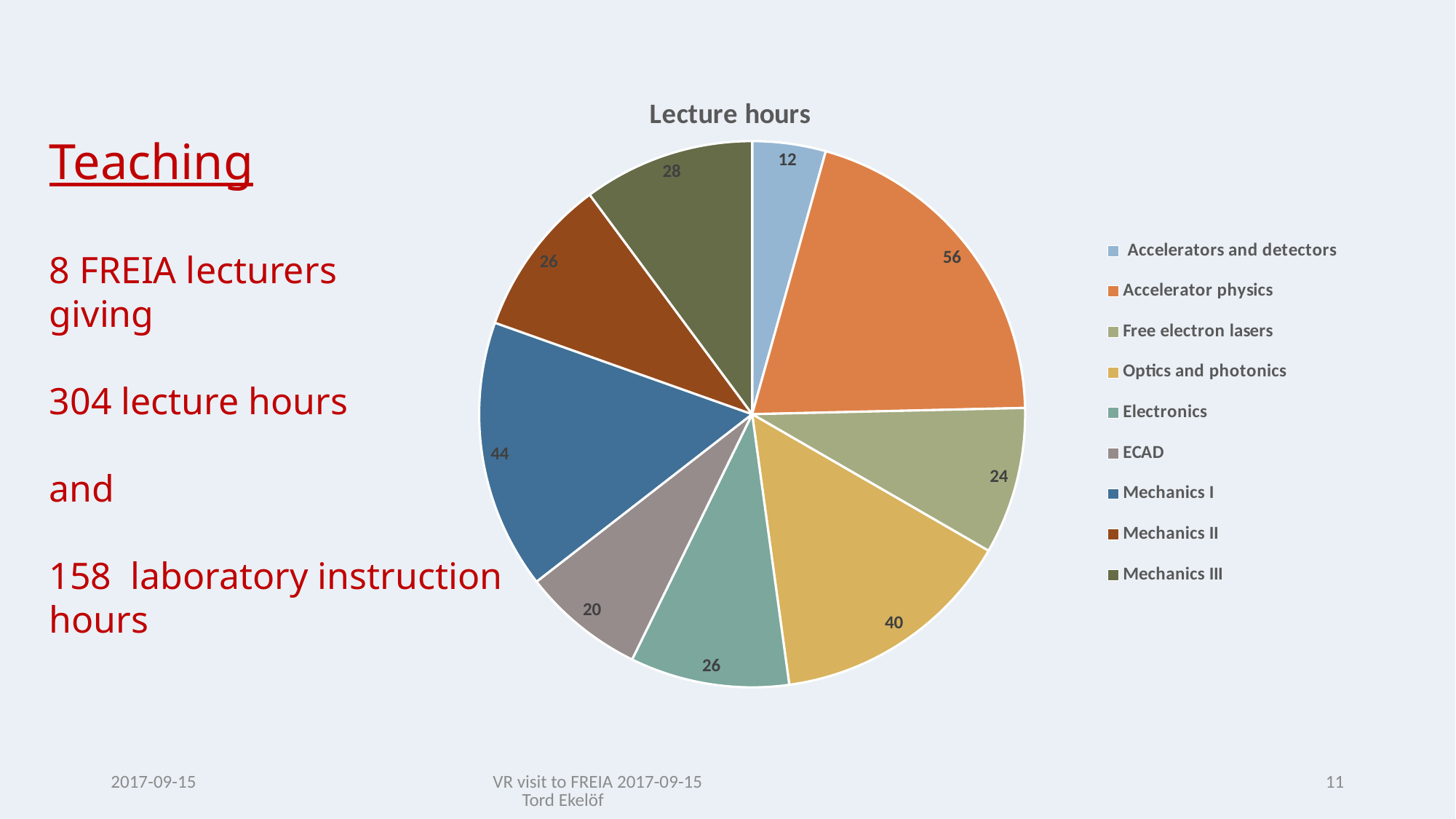
Which category has the smallest slice of the pie? Accelerators and detectors How many lecture hours are shown for Optics and photonics? 40 Which has more lecture hours, Free electron lasers or Mechanics III? Mechanics III What is the title of the chart? Lecture hours How many lecture hours are shown for Accelerator physics? 56 What type of chart is shown on the slide? Pie chart How many lecture hours are shown for ECAD? 20 What colour is the Electronics slice? Teal How many lecture hours are shown for Mechanics I? 44 Which category has the largest slice of the pie? Accelerator physics How many categories does the pie chart have? 9 What is the difference in lecture hours between Accelerator physics and Mechanics I? 12